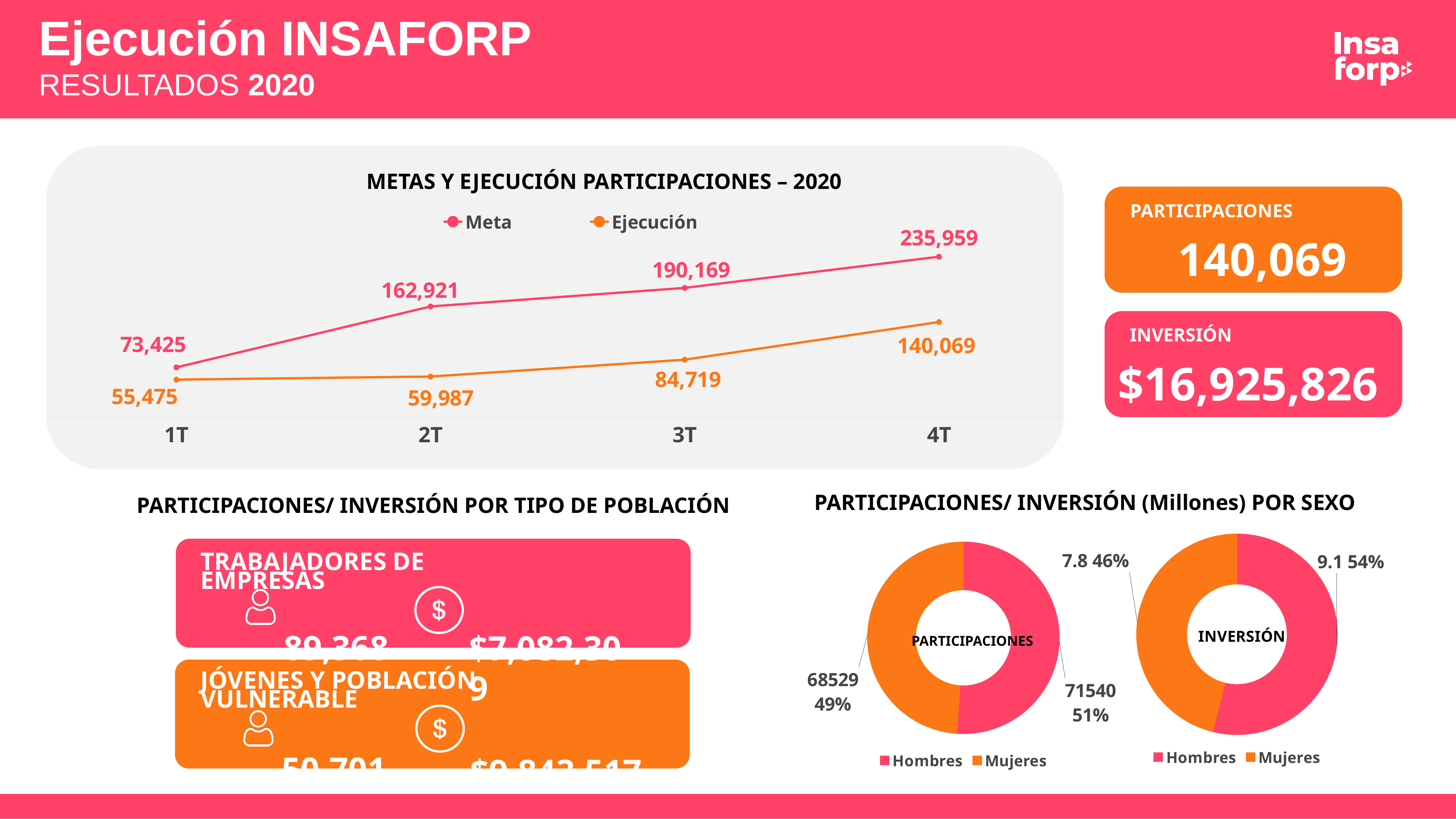
In the PARTICIPACIONES donut chart under 'PARTICIPACIONES/ INVERSIÓN (Millones) POR SEXO', what is the value for Hombres? 71540 In the chart 'METAS Y EJECUCIÓN PARTICIPACIONES – 2020', what is the Ejecución value for 3T? 84,719 In the INVERSIÓN donut chart under 'PARTICIPACIONES/ INVERSIÓN (Millones) POR SEXO', which is larger, Hombres or Mujeres? Hombres In the chart 'METAS Y EJECUCIÓN PARTICIPACIONES – 2020', how many series does the legend list? 2 In the chart 'METAS Y EJECUCIÓN PARTICIPACIONES – 2020', in which quarter is the Ejecución value lowest? 1T In the INVERSIÓN donut chart under 'PARTICIPACIONES/ INVERSIÓN (Millones) POR SEXO', what is the value for Mujeres? 7.8 What kind of chart is 'METAS Y EJECUCIÓN PARTICIPACIONES – 2020'? line chart In the PARTICIPACIONES donut chart under 'PARTICIPACIONES/ INVERSIÓN (Millones) POR SEXO', what share of the total is Mujeres? 49% In the chart 'METAS Y EJECUCIÓN PARTICIPACIONES – 2020', does the Ejecución series rise or fall from 1T to 4T? rise In the chart 'METAS Y EJECUCIÓN PARTICIPACIONES – 2020', how many quarters are shown on the x axis? 4 In the chart 'METAS Y EJECUCIÓN PARTICIPACIONES – 2020', what is the difference between the Meta and Ejecución values in 2T? 102,934 In the chart 'METAS Y EJECUCIÓN PARTICIPACIONES – 2020', what is the Meta value for 4T? 235,959